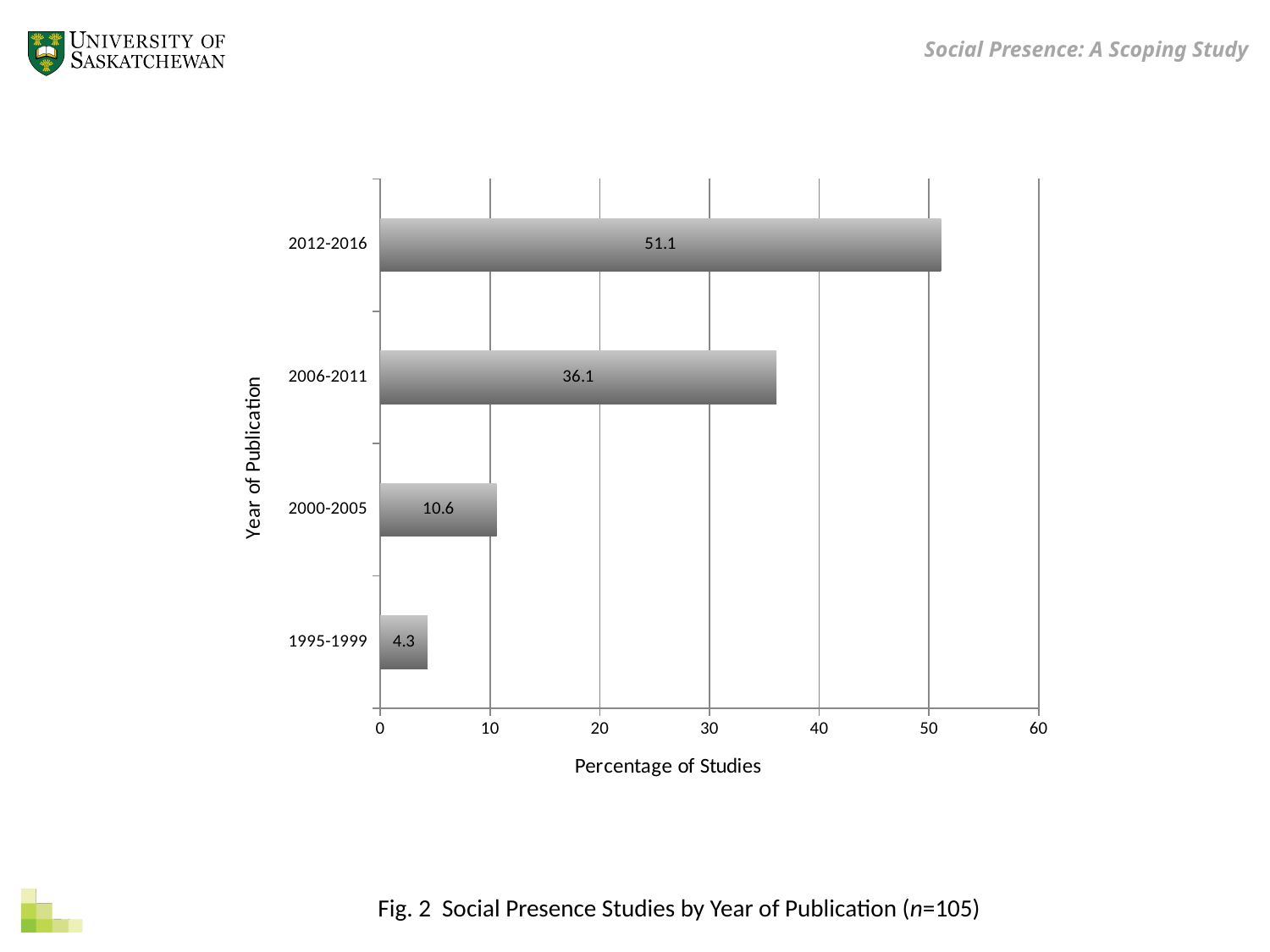
What is the percentage of studies for 2012-2016? 51.1 Is the value for 2006-2011 greater or less than 40? less What is the percentage of studies for 2000-2005? 10.6 Which year of publication range has the lowest percentage of studies? 1995-1999 Which year of publication range has the highest percentage of studies? 2012-2016 What is the label of the horizontal axis of the chart? Percentage of Studies What is the percentage of studies for 2006-2011? 36.1 How many year of publication categories are shown in the chart? 4 What kind of chart is shown on the slide? bar chart Which has a larger percentage of studies, 2000-2005 or 1995-1999? 2000-2005 What is the percentage of studies for 1995-1999? 4.3 What is the difference in percentage of studies between 2012-2016 and 2006-2011? 15